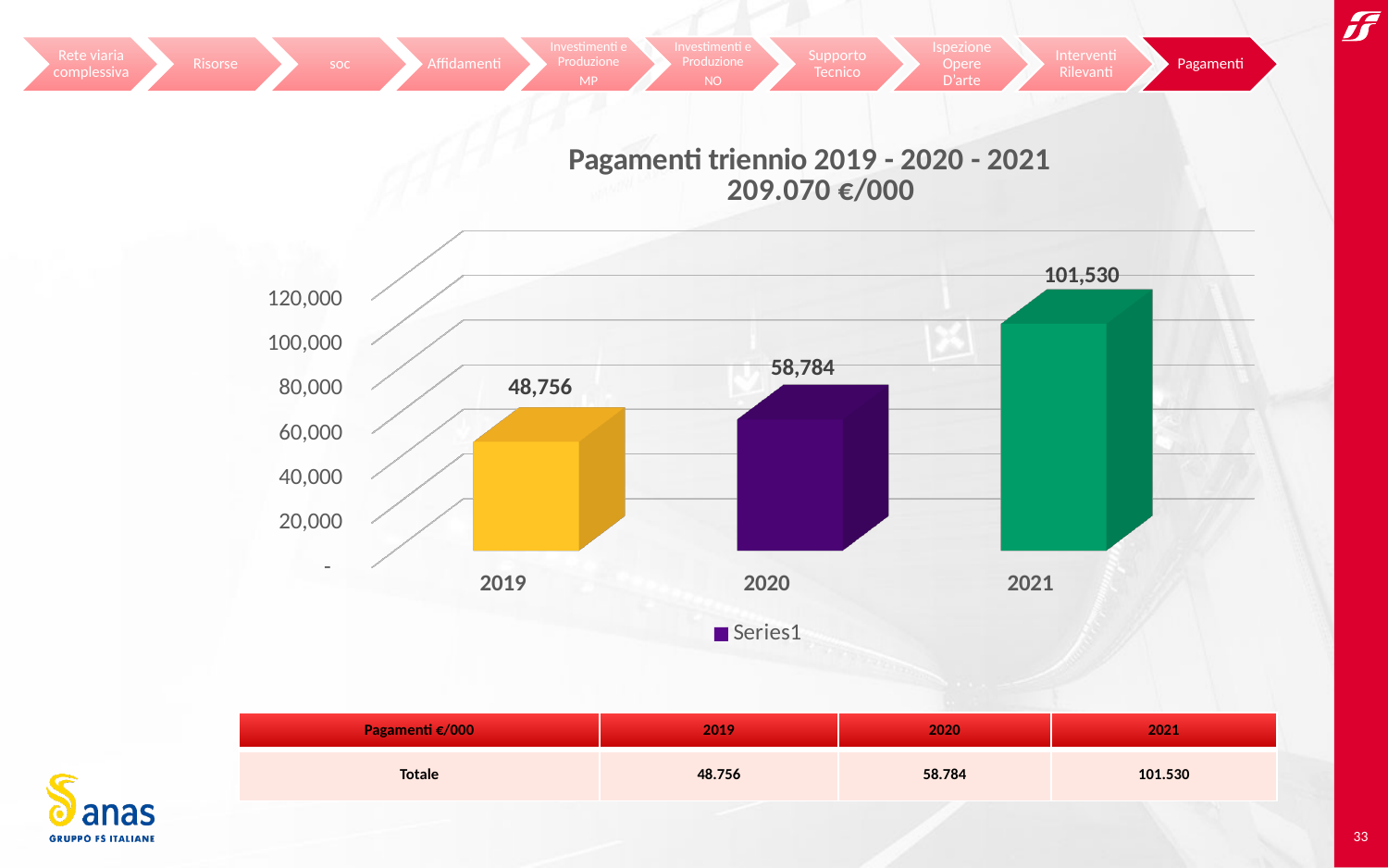
What kind of chart is shown? bar chart What is the value for 2019? 48,756 What is the value for 2020? 58,784 Is the value for 2021 greater or less than 100,000? greater Which year has the lowest value? 2019 Which is larger, the value for 2020 or the value for 2019? 2020 What is the difference between the values for 2020 and 2019? 10,028 Which year has the highest value? 2021 Do the values rise or fall from 2019 to 2021? rise What is the difference between the values for 2021 and 2020? 42,746 What is the value for 2021? 101,530 How many years are shown on the x axis? 3